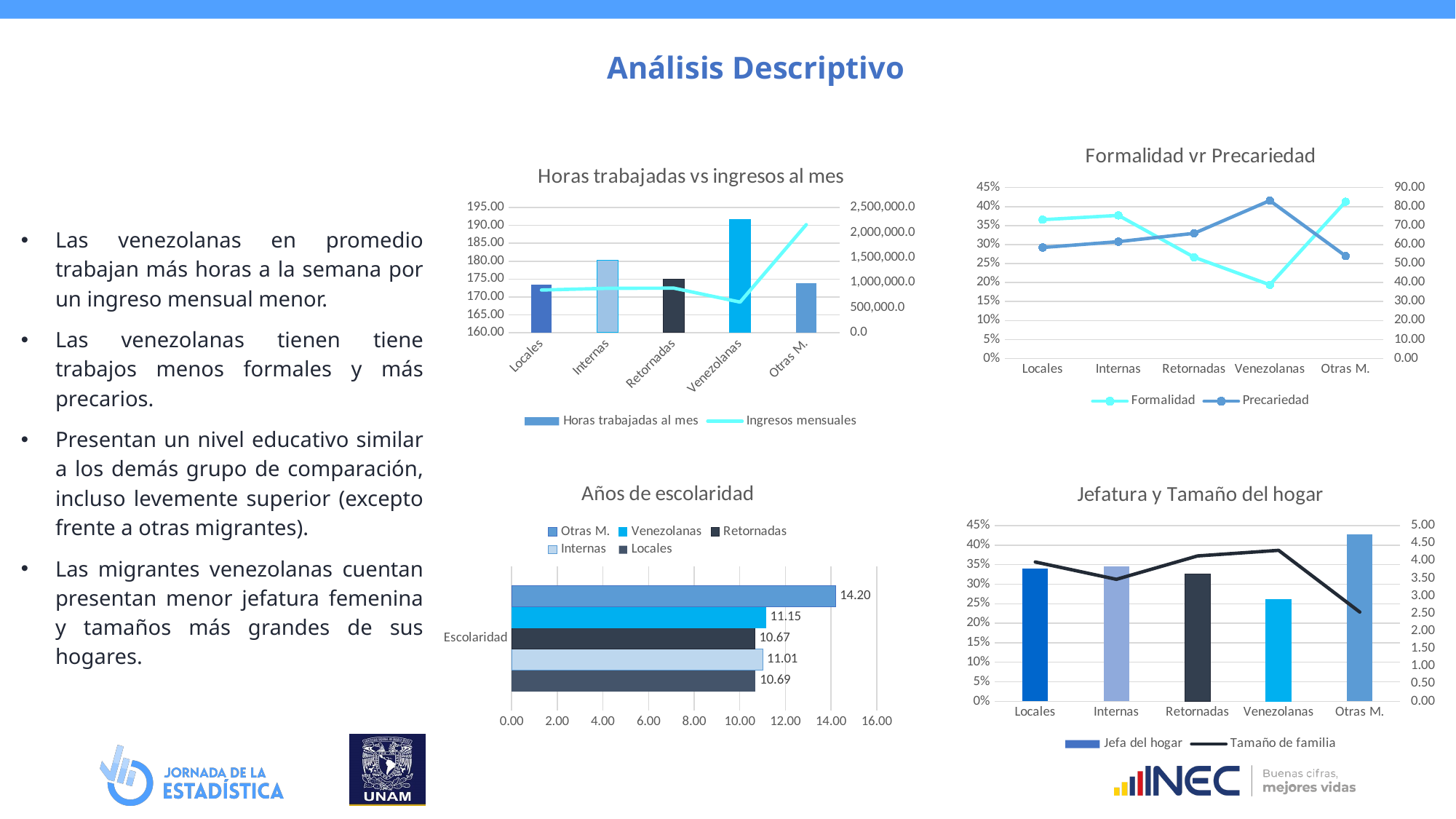
In the 'Formalidad vr Precariedad' chart, which category has the highest Precariedad value? Venezolanas In the 'Años de escolaridad' chart, what is the value for Venezolanas? 11.15 In the 'Años de escolaridad' chart, which group has the lowest value? Retornadas In the 'Años de escolaridad' chart, what is the difference between the values for Otras M. and Venezolanas? 3.05 In the 'Jefatura y Tamaño del hogar' chart, how many series does the legend list? 2 In the 'Años de escolaridad' chart, which group has the highest value? Otras M. In the 'Horas trabajadas vs ingresos al mes' chart, is the 'Horas trabajadas al mes' value for Venezolanas greater or less than 190.00? greater In the 'Jefatura y Tamaño del hogar' chart, which category has the tallest 'Jefa del hogar' bar? Otras M. In the 'Años de escolaridad' chart, what is the value for Otras M.? 14.20 What kind of chart is 'Años de escolaridad'? bar chart In the 'Formalidad vr Precariedad' chart, which category has the lowest Formalidad value? Venezolanas